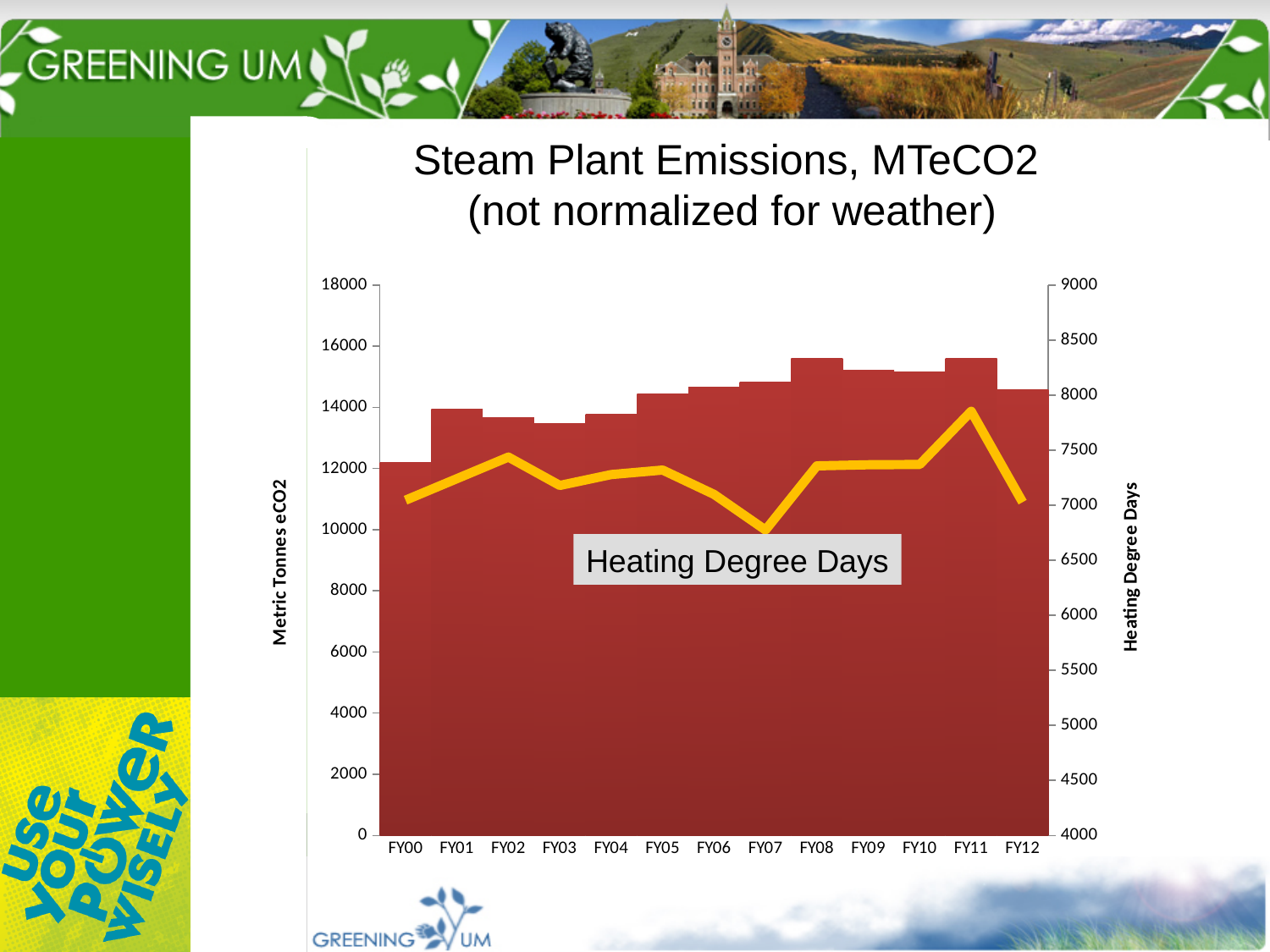
Which fiscal year has higher emissions, FY00 or FY01? FY01 Which fiscal year has the lowest emissions bar? FY00 In which fiscal year does the Heating Degree Days line reach its highest point? FY11 In which fiscal year does the Heating Degree Days line reach its lowest point? FY07 How many fiscal years are shown along the x axis of the chart? 13 What is the label on the right-hand vertical axis of the chart? Heating Degree Days Is the Heating Degree Days value for FY07 greater or less than 7000? less What kind of chart is used to show the emissions data? bar chart Is the emissions value for FY00 greater or less than 14000 metric tonnes eCO2? less What is the title of the chart? Steam Plant Emissions, MTeCO2 (not normalized for weather) Is the emissions value for FY08 greater or less than 15000 metric tonnes eCO2? greater Do the emissions bars generally rise or fall from FY00 to FY11? rise